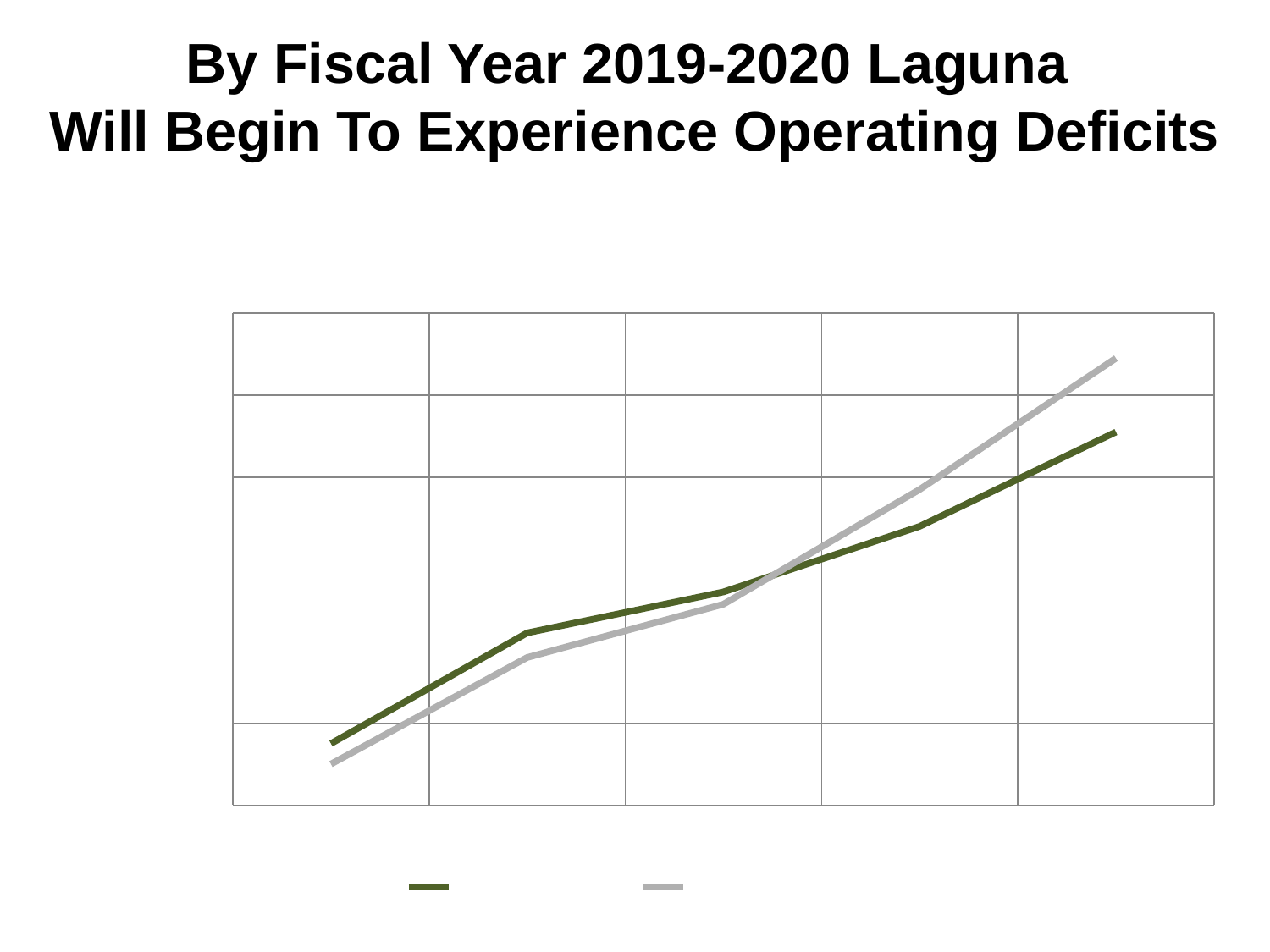
Which line reaches the highest point on the chart? gray line What is the title of the slide? By Fiscal Year 2019-2020 Laguna Will Begin To Experience Operating Deficits How many data points does the green line have? 5 At the rightmost point, which line is higher, the green line or the gray line? gray line Do the values of the green line rise or fall from left to right? rise At the second point from the left, which line is higher, the green line or the gray line? green line What kind of chart is shown on the slide? line chart How many series does the legend list? 2 What two colours are the lines on the chart? green and gray At the leftmost point, which line is higher, the green line or the gray line? green line How many data points does the gray line have? 5 Do the values of the gray line rise or fall from left to right? rise